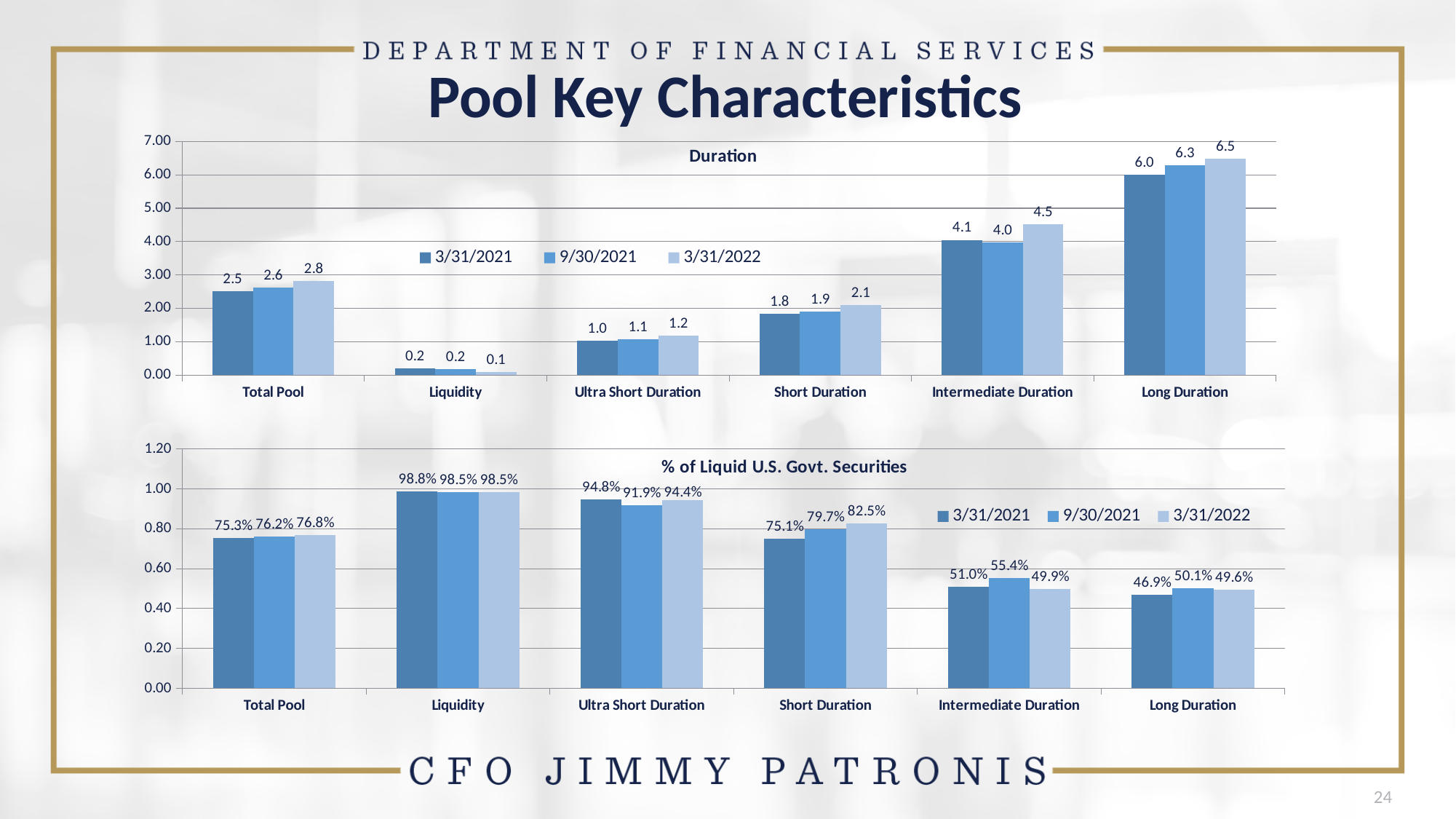
In the Duration chart, which category has the lowest value on 3/31/2022? Liquidity In the Duration chart, how many series does the legend list? 3 In the Duration chart, do the values for Short Duration rise or fall from 3/31/2021 to 3/31/2022? rise In the % of Liquid U.S. Govt. Securities chart, which category has the lowest value on 3/31/2021? Long Duration In the % of Liquid U.S. Govt. Securities chart, what is the value for Short Duration on 9/30/2021? 79.7% In the Duration chart, what is the difference between the Long Duration values on 3/31/2022 and 3/31/2021? 0.5 In the % of Liquid U.S. Govt. Securities chart, which category has the highest value on 3/31/2021? Liquidity In the % of Liquid U.S. Govt. Securities chart, is the value for Intermediate Duration on 9/30/2021 larger or smaller than the value for Long Duration on 9/30/2021? larger What kind of chart is the % of Liquid U.S. Govt. Securities chart? bar chart In the Duration chart, what is the value for Long Duration on 3/31/2022? 6.5 In the Duration chart, how many categories are shown on the x axis? 6 In the Duration chart, what is the value for Total Pool on 3/31/2021? 2.5